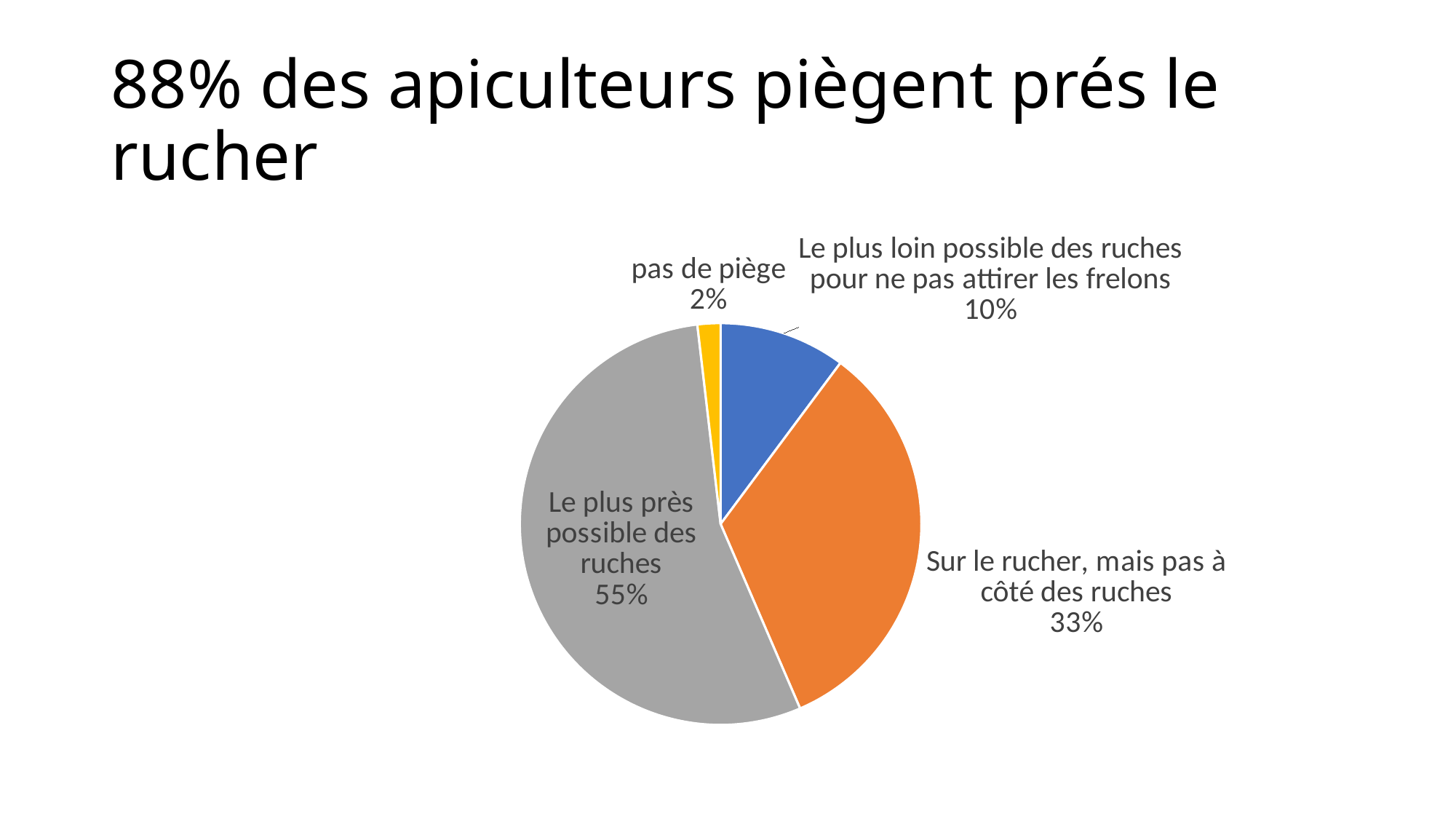
What share of the pie does "pas de piège" represent? 2% What is the difference in percentage points between "Le plus près possible des ruches" and "Sur le rucher, mais pas à côté des ruches"? 22 percentage points Which category has the smallest slice of the pie? pas de piège How many slices does the pie chart have? 4 What kind of chart is shown on the slide? Pie chart What is the combined share of "Le plus près possible des ruches" and "Sur le rucher, mais pas à côté des ruches"? 88% Which category has the largest slice of the pie? Le plus près possible des ruches What colour is the slice for "Sur le rucher, mais pas à côté des ruches"? Orange What share of the pie does "Le plus loin possible des ruches pour ne pas attirer les frelons" represent? 10% What share of the pie does "Sur le rucher, mais pas à côté des ruches" represent? 33% Which is larger: the slice for "Le plus loin possible des ruches pour ne pas attirer les frelons" or the slice for "pas de piège"? Le plus loin possible des ruches pour ne pas attirer les frelons